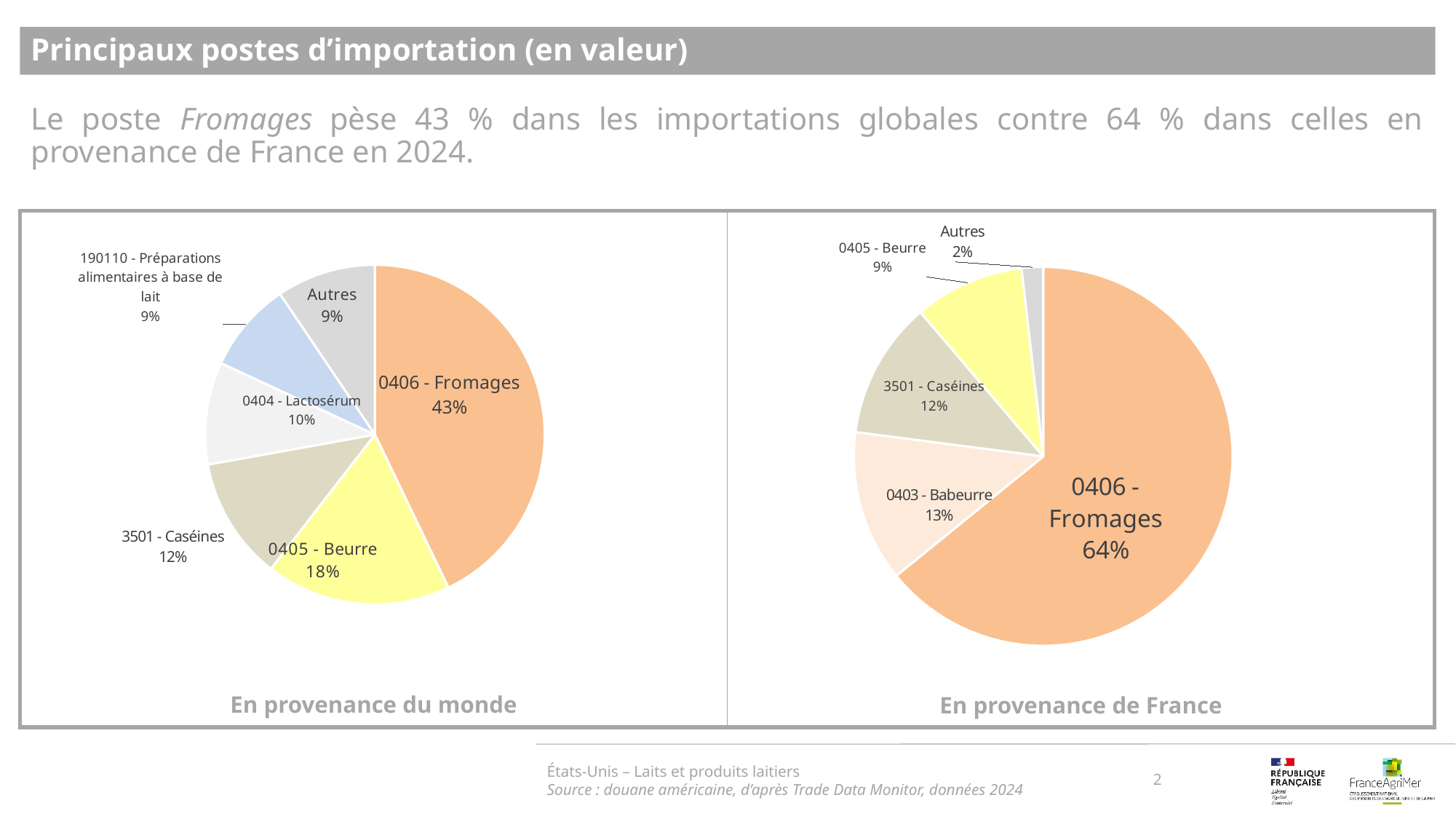
In the 'En provenance de France' chart, which category has the smallest slice? Autres In the 'En provenance du monde' chart, what share does 0406 - Fromages have? 43% In the 'En provenance du monde' chart, what is the value for 0404 - Lactosérum? 10% What is the difference between the 0406 - Fromages share in the 'En provenance de France' chart and in the 'En provenance du monde' chart? 21% In the 'En provenance du monde' chart, which category has the largest slice? 0406 - Fromages In the 'En provenance de France' chart, what share does 0406 - Fromages have? 64% In the 'En provenance du monde' chart, what is the value for 0405 - Beurre? 18% In the 'En provenance du monde' chart, which is larger: 0405 - Beurre or 3501 - Caséines? 0405 - Beurre What type of chart is the 'En provenance de France' chart? Pie chart How many slices does the 'En provenance du monde' chart have? 6 How many slices does the 'En provenance de France' chart have? 5 In the 'En provenance de France' chart, what is the value for 0403 - Babeurre? 13%